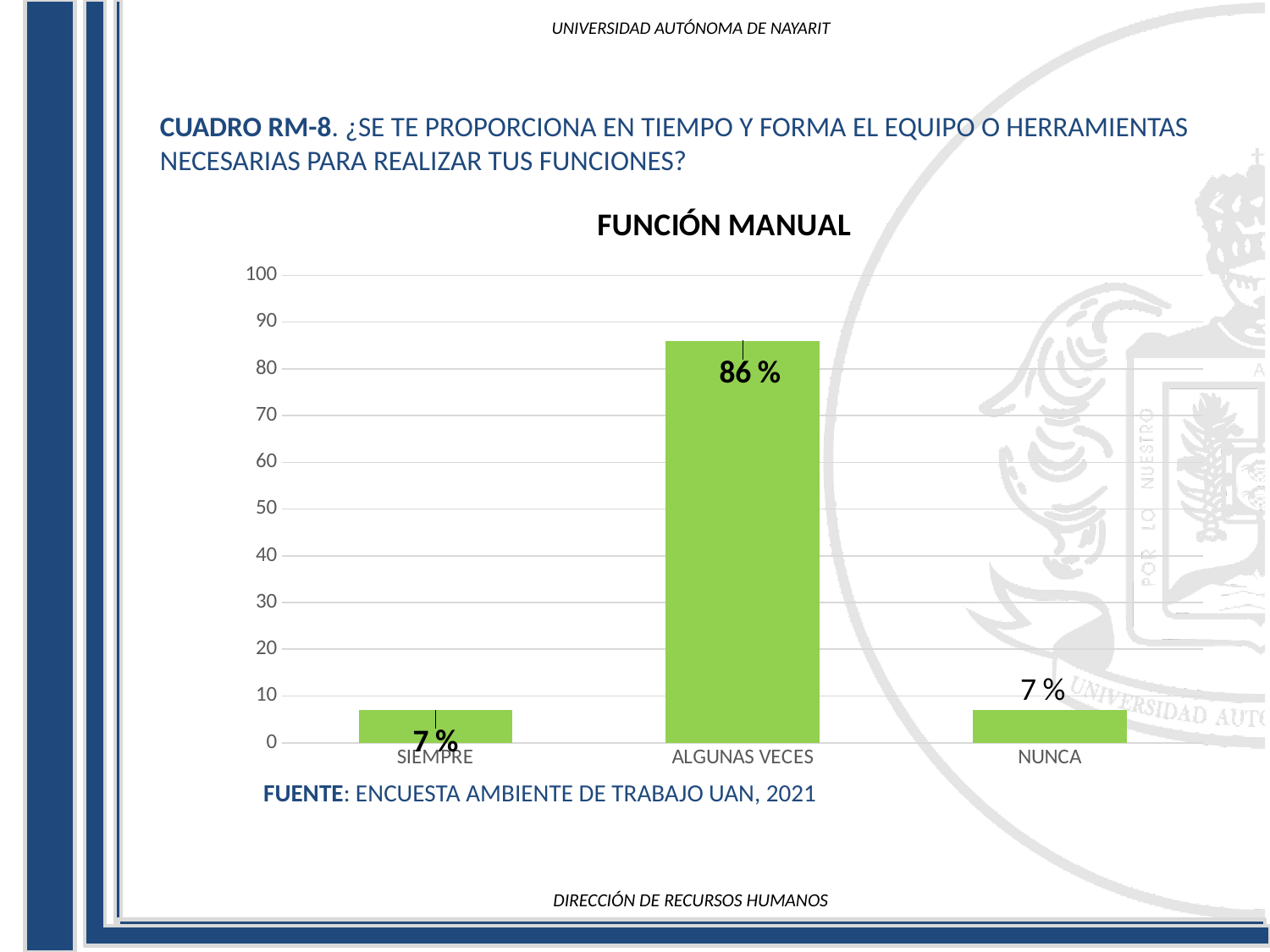
What is the difference between the values for ALGUNAS VECES and NUNCA? 79 % What is the value for ALGUNAS VECES? 86 % What kind of chart is shown on the slide? bar chart What is the difference between the values for ALGUNAS VECES and SIEMPRE? 79 % Which category has the highest value? ALGUNAS VECES What is the title of the chart? FUNCIÓN MANUAL How many categories are shown on the x axis? 3 Is the value for ALGUNAS VECES greater or less than 80? greater What is the value for SIEMPRE? 7 % Which is larger, the value for ALGUNAS VECES or the value for SIEMPRE? ALGUNAS VECES Is the value for NUNCA greater or less than 10? less What is the value for NUNCA? 7 %